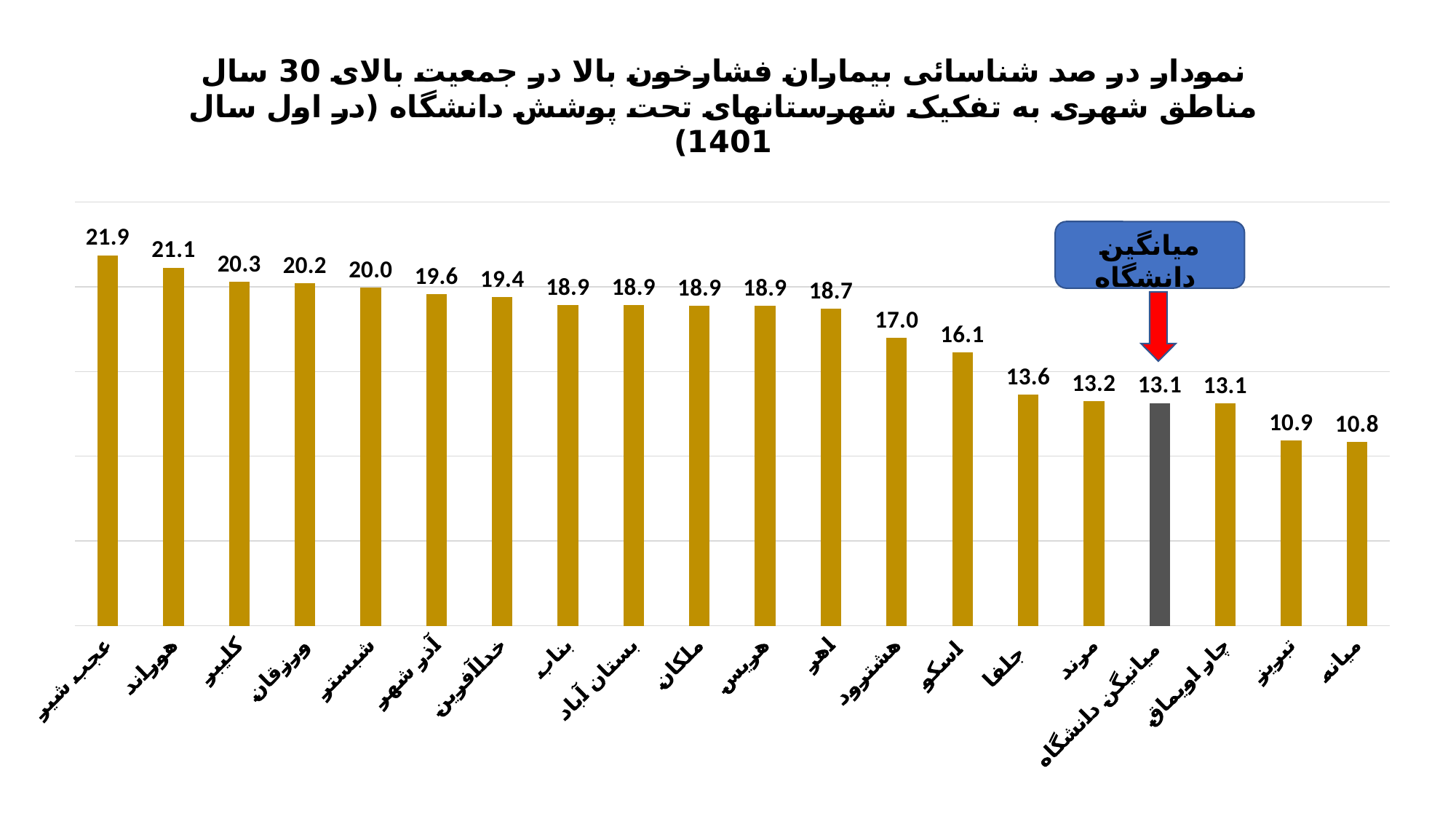
What kind of chart is shown on the slide? bar chart What is the value for میانگین دانشگاه? 13.1 How many bars are shown in the chart? 20 What is the value for هشترود? 17.0 Which category has the lowest value? میانه What is the value for تبریز? 10.9 Which category has the highest value? عجب شیر What is the difference between the values for عجب شیر and میانه? 11.1 What is the value for عجب شیر? 21.9 Which is larger, the value for اسکو or the value for هشترود? هشترود Which bar is coloured differently (dark grey) from the others? میانگین دانشگاه What is the difference between the values for جلفا and مرند? 0.4